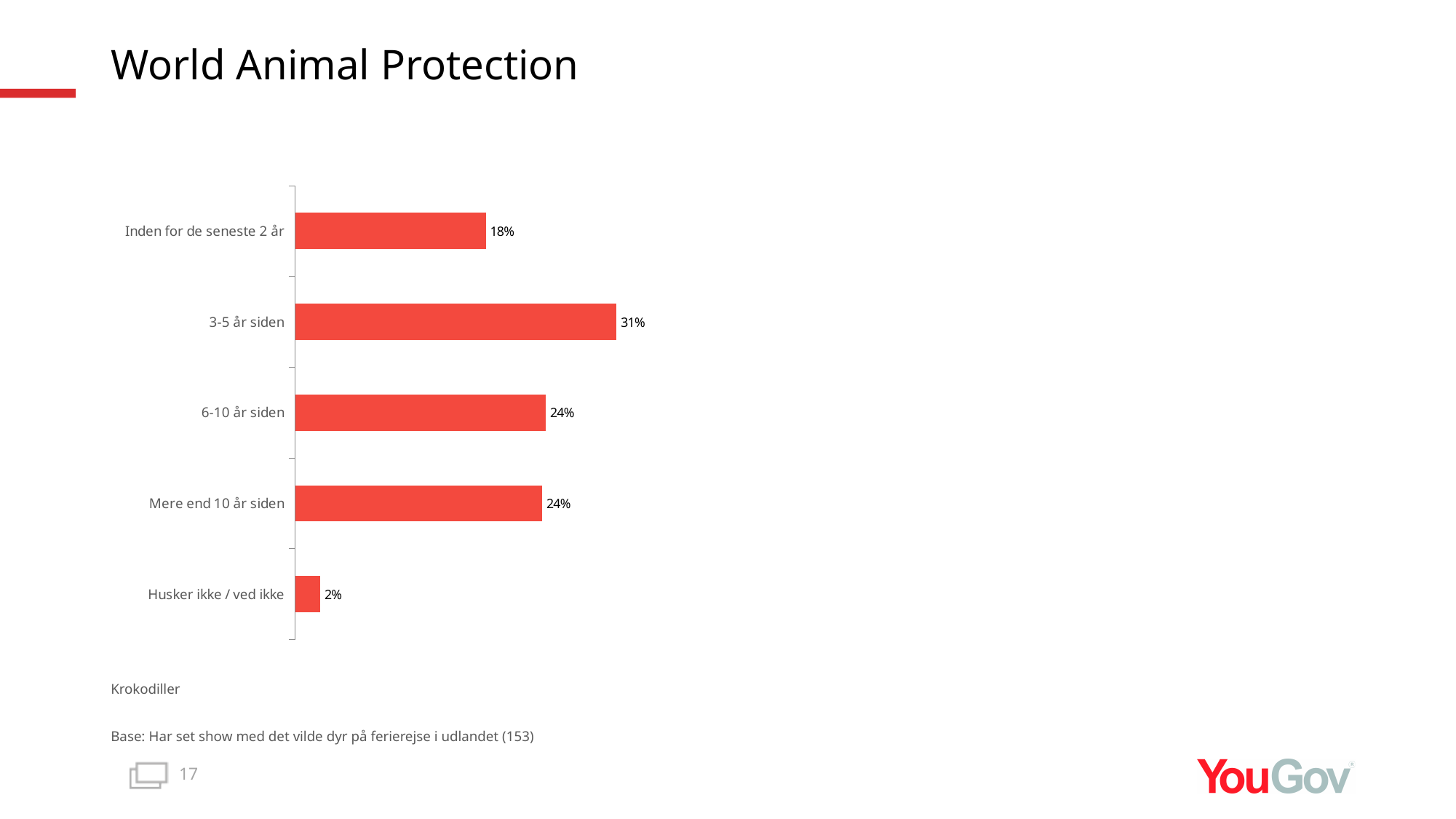
What kind of chart is shown on the slide? Bar chart What is the value for "3-5 år siden"? 31% Which category has the lowest value? Husker ikke / ved ikke Which category has the highest value? 3-5 år siden How many categories are shown in the chart? 5 What is the value for "Inden for de seneste 2 år"? 18% What is the difference between the values for "3-5 år siden" and "6-10 år siden"? 7 percentage points What label appears below the chart identifying the animal the data refers to? Krokodiller What is the value for "Mere end 10 år siden"? 24% Which is larger: the value for "Inden for de seneste 2 år" or the value for "6-10 år siden"? 6-10 år siden What is the difference between the values for "Inden for de seneste 2 år" and "Husker ikke / ved ikke"? 16 percentage points What is the value for "Husker ikke / ved ikke"? 2%